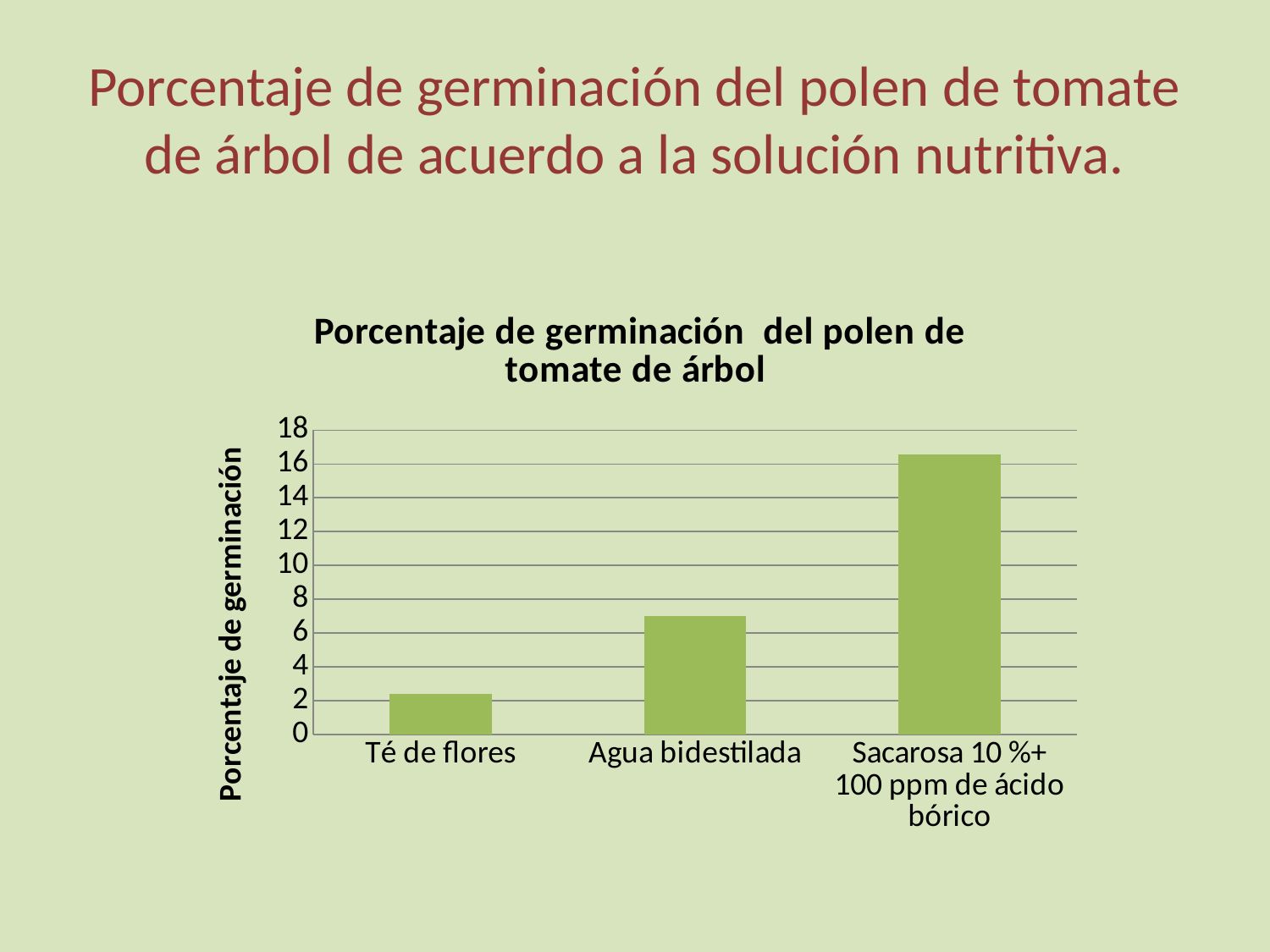
Which has a higher germination percentage, Té de flores or Agua bidestilada? Agua bidestilada Is the value for Té de flores greater or less than 4? less What kind of chart is shown on the slide? bar chart Is the value for Agua bidestilada greater or less than 6? greater Is the value for Agua bidestilada greater or less than 8? less Do the values rise or fall from left to right along the x axis? rise Which nutrient solution has the highest germination percentage? Sacarosa 10 %+ 100 ppm de ácido bórico What is the maximum value shown on the vertical axis of the chart? 18 How many categories (nutrient solutions) are shown on the x axis of the chart? 3 Which nutrient solution has the lowest germination percentage? Té de flores What is the label of the vertical axis of the chart? Porcentaje de germinación